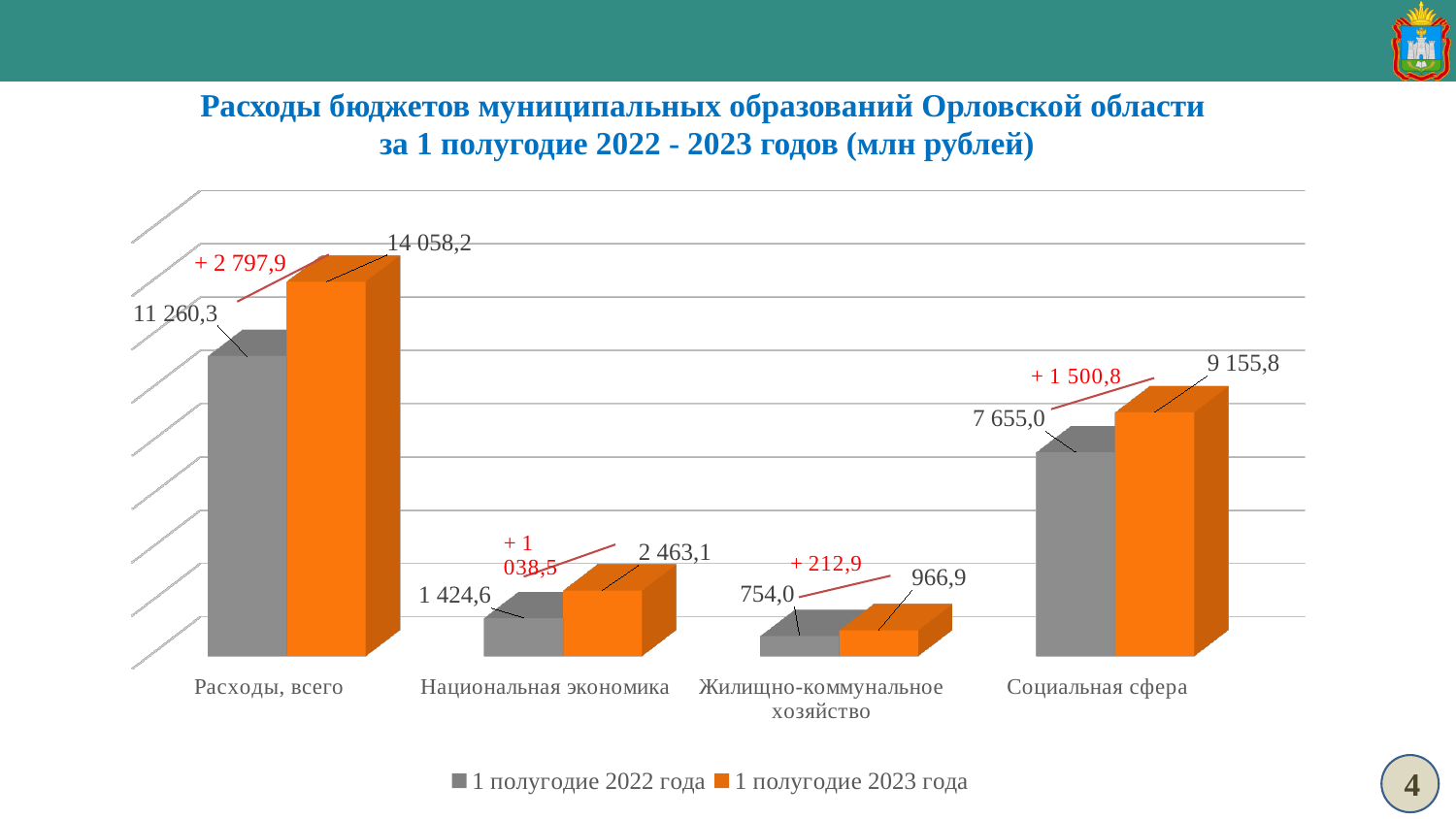
Which is larger for Национальная экономика: the 1 полугодие 2022 года value or the 1 полугодие 2023 года value? 1 полугодие 2023 года Which category has the lowest value in the 1 полугодие 2022 года series? Жилищно-коммунальное хозяйство What is the value for Социальная сфера in the 1 полугодие 2022 года series? 7 655,0 What is the value for Расходы, всего in the 1 полугодие 2023 года series? 14 058,2 Which category has the highest value in the 1 полугодие 2023 года series? Расходы, всего How many series does the legend list? 2 What kind of chart is shown on the slide? Bar chart What is the value for Национальная экономика in the 1 полугодие 2022 года series? 1 424,6 What is the difference between the 1 полугодие 2023 года and 1 полугодие 2022 года values for Жилищно-коммунальное хозяйство? 212,9 What is the difference between the 1 полугодие 2023 года and 1 полугодие 2022 года values for Социальная сфера? 1 500,8 How many categories are shown on the x axis? 4 What is the value for Жилищно-коммунальное хозяйство in the 1 полугодие 2023 года series? 966,9